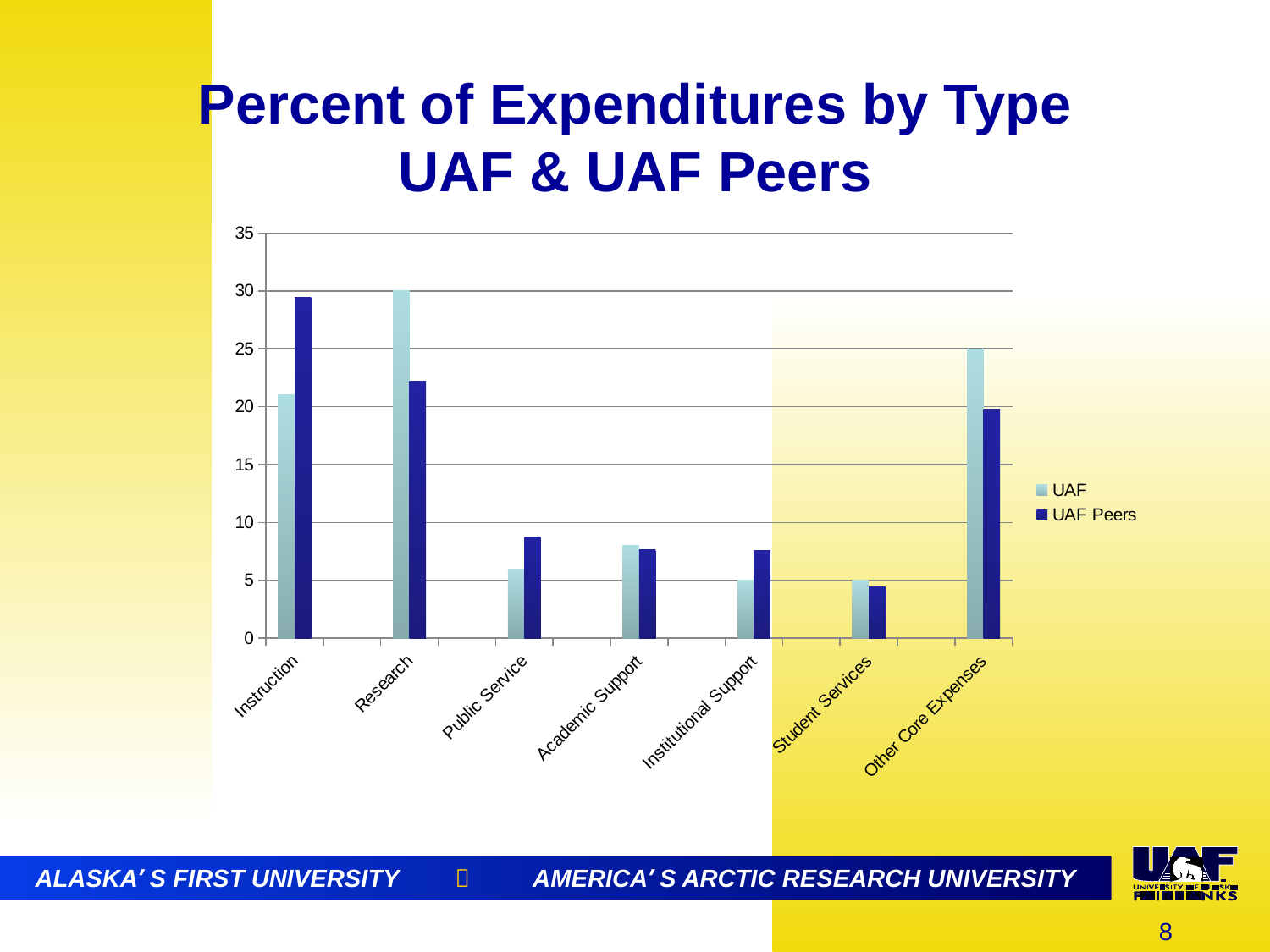
How many expenditure categories are shown on the x axis? 7 Which category has the lowest value for the UAF Peers series? Student Services Is the UAF Peers value for Instruction greater or less than 25? greater Which category has the highest value for the UAF Peers series? Instruction For Other Core Expenses, which is larger: the UAF value or the UAF Peers value? UAF For Research, which is larger: the UAF value or the UAF Peers value? UAF How many series does the legend list? 2 Which category has the highest value for the UAF series? Research Is the UAF Peers value for Public Service greater or less than 10? less What are the two series named in the legend? UAF and UAF Peers What kind of chart is shown on the slide? bar chart For Instruction, which is larger: the UAF value or the UAF Peers value? UAF Peers